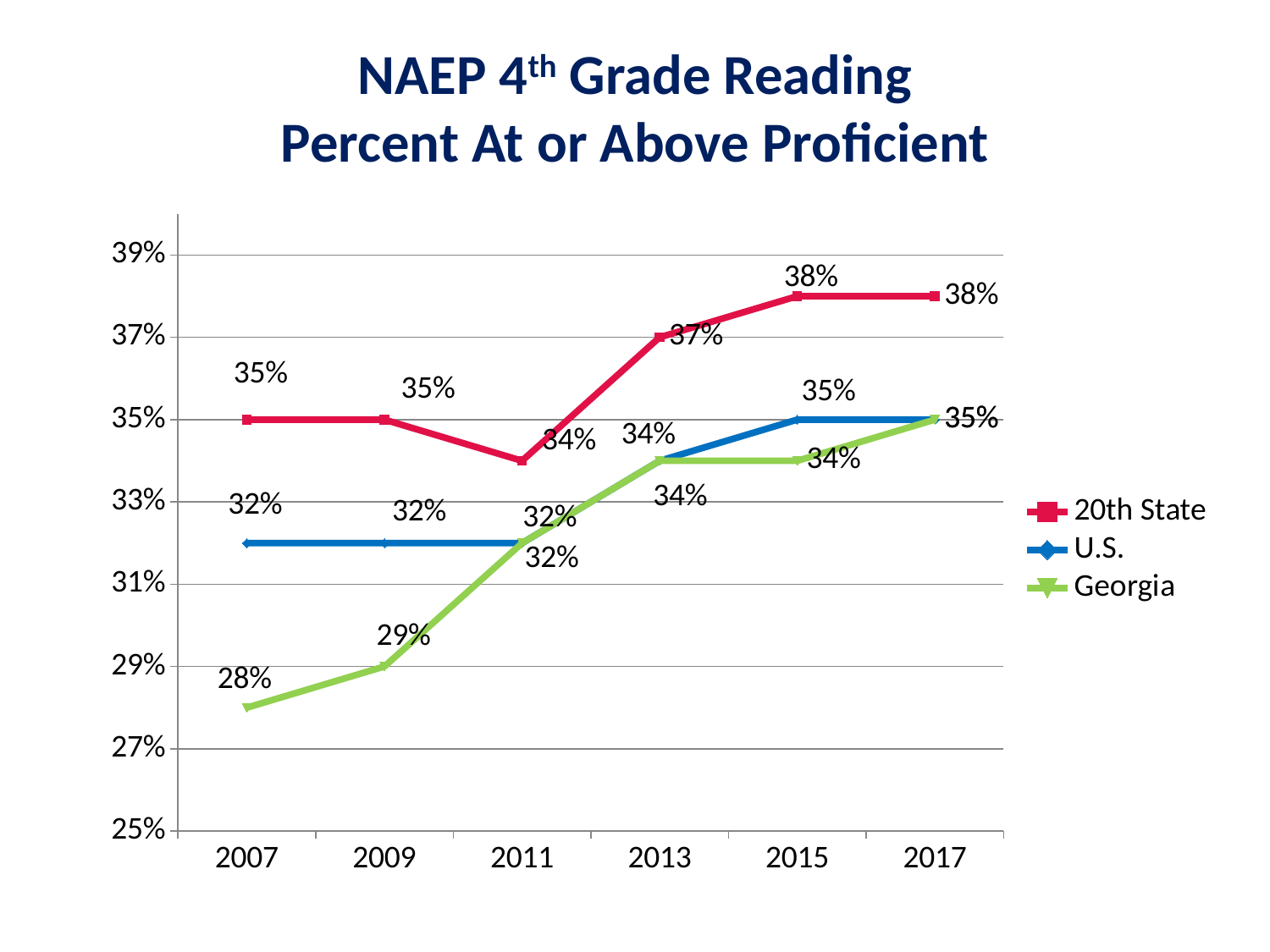
What was Georgia's value in 2009? 29% Which was higher in 2015, the U.S. value or Georgia's value? U.S. How many years are plotted along the x axis? 6 In which year was Georgia's value lowest? 2007 What type of chart is shown on the slide? Line chart What was Georgia's percent at or above proficient in 2007? 28% How many series does the legend list? 3 What is the difference between the 20th State value and Georgia's value in 2007? 7 percentage points What was the U.S. value in 2013? 34% Which series is shown in red? 20th State What was the 20th State value in 2015? 38% Does Georgia's line generally rise or fall from 2007 to 2017? Rise